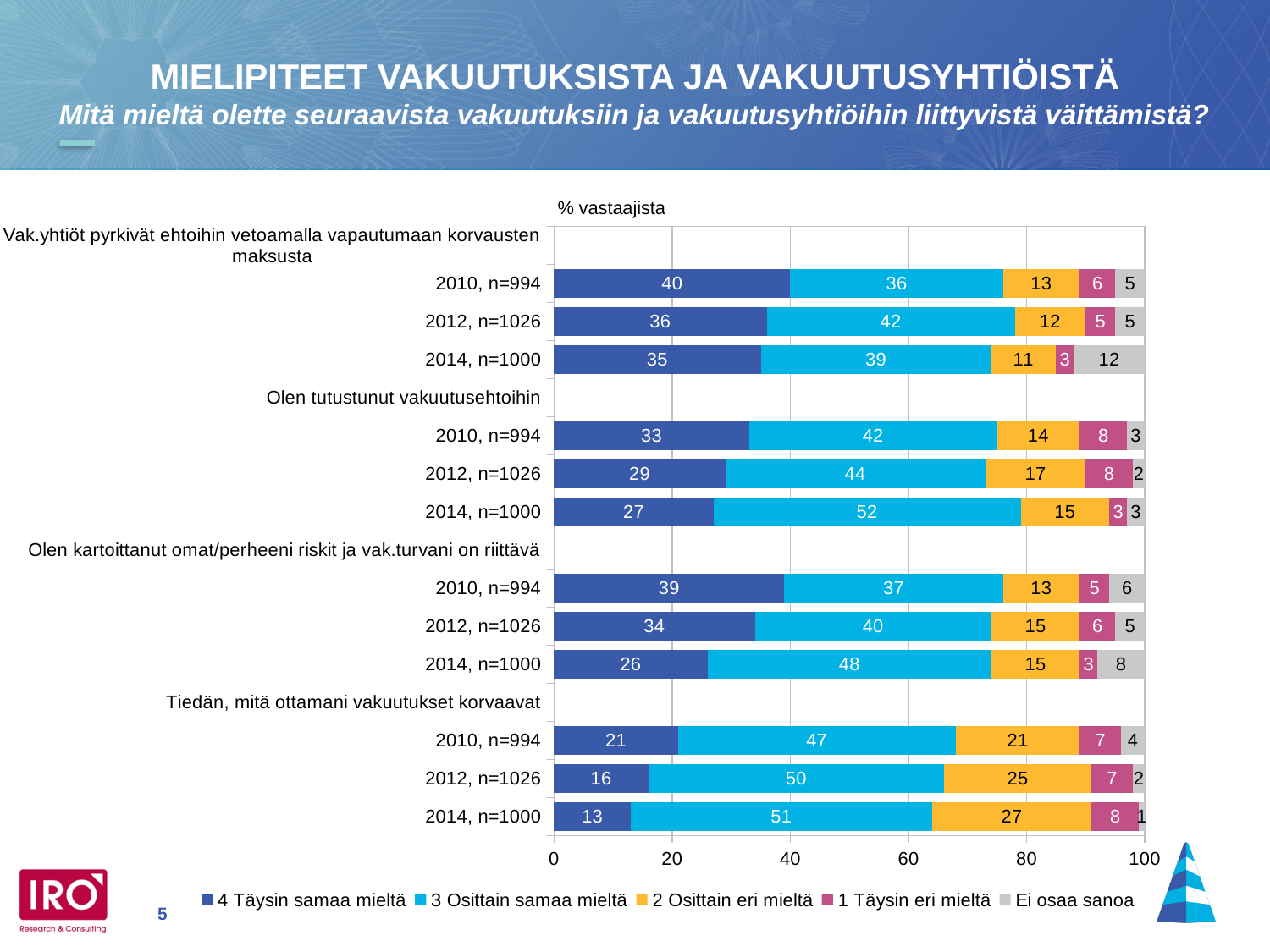
Which bar has the highest value for "4 Täysin samaa mieltä"? Vak.yhtiöt pyrkivät ehtoihin vetoamalla vapautumaan korvausten maksusta, 2010, n=994 What is the value of "1 Täysin eri mieltä" for "Olen tutustunut vakuutusehtoihin" in 2012, n=1026? 8 What is the total of the stacked bar for "Olen tutustunut vakuutusehtoihin" in 2010, n=994? 100 What is the value of "4 Täysin samaa mieltä" for "Tiedän, mitä ottamani vakuutukset korvaavat" in 2014, n=1000? 13 How many series does the legend list? 5 What is the value of "3 Osittain samaa mieltä" for "Olen tutustunut vakuutusehtoihin" in 2014, n=1000? 52 For "Tiedän, mitä ottamani vakuutukset korvaavat", does the value of "4 Täysin samaa mieltä" rise or fall from 2010 to 2014? fall For "Tiedän, mitä ottamani vakuutukset korvaavat", what is the difference in "2 Osittain eri mieltä" between 2014, n=1000 and 2010, n=994? 6 How many stacked bars are plotted in the chart? 12 What is the value of "Ei osaa sanoa" for "Vak.yhtiöt pyrkivät ehtoihin vetoamalla vapautumaan korvausten maksusta" in 2014, n=1000? 12 What kind of chart is shown on the slide? bar chart For "Olen kartoittanut omat/perheeni riskit ja vak.turvani on riittävä", which year has the larger value for "3 Osittain samaa mieltä": 2012, n=1026 or 2014, n=1000? 2014, n=1000